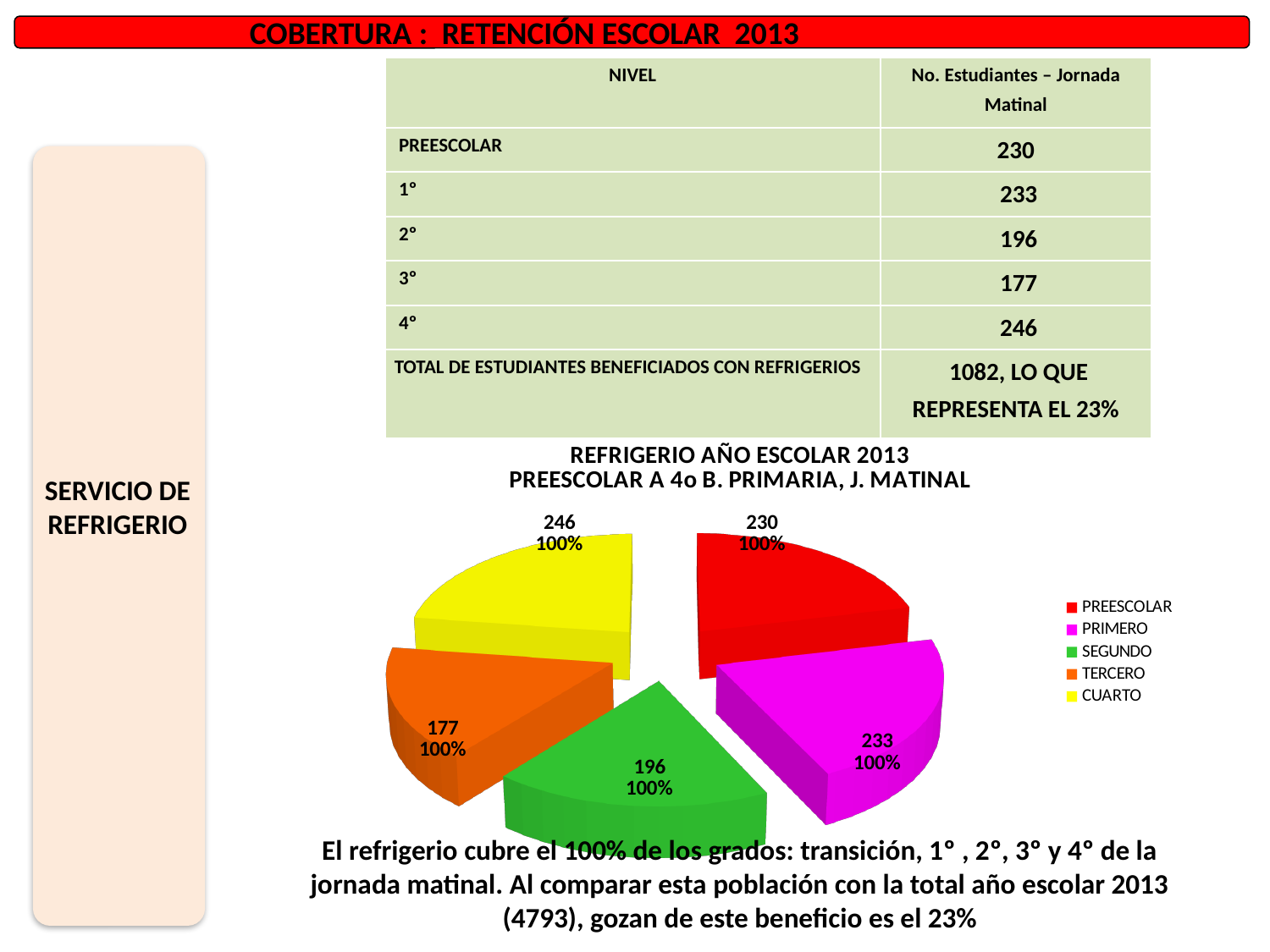
How many categories does the legend of the pie chart list? 5 What is the value shown for SEGUNDO in the pie chart? 196 What is the value shown for PREESCOLAR in the pie chart? 230 Which category has the smallest value in the pie chart? TERCERO Which has a larger value in the pie chart, PRIMERO or PREESCOLAR? PRIMERO Which category has the largest value in the pie chart? CUARTO What type of chart is shown on the slide? Pie chart Which colour represents CUARTO in the pie chart? Yellow What is the value shown for TERCERO in the pie chart? 177 What is the value shown for CUARTO in the pie chart? 246 What is the difference between the values for CUARTO and TERCERO in the pie chart? 69 What is the value shown for PRIMERO in the pie chart? 233